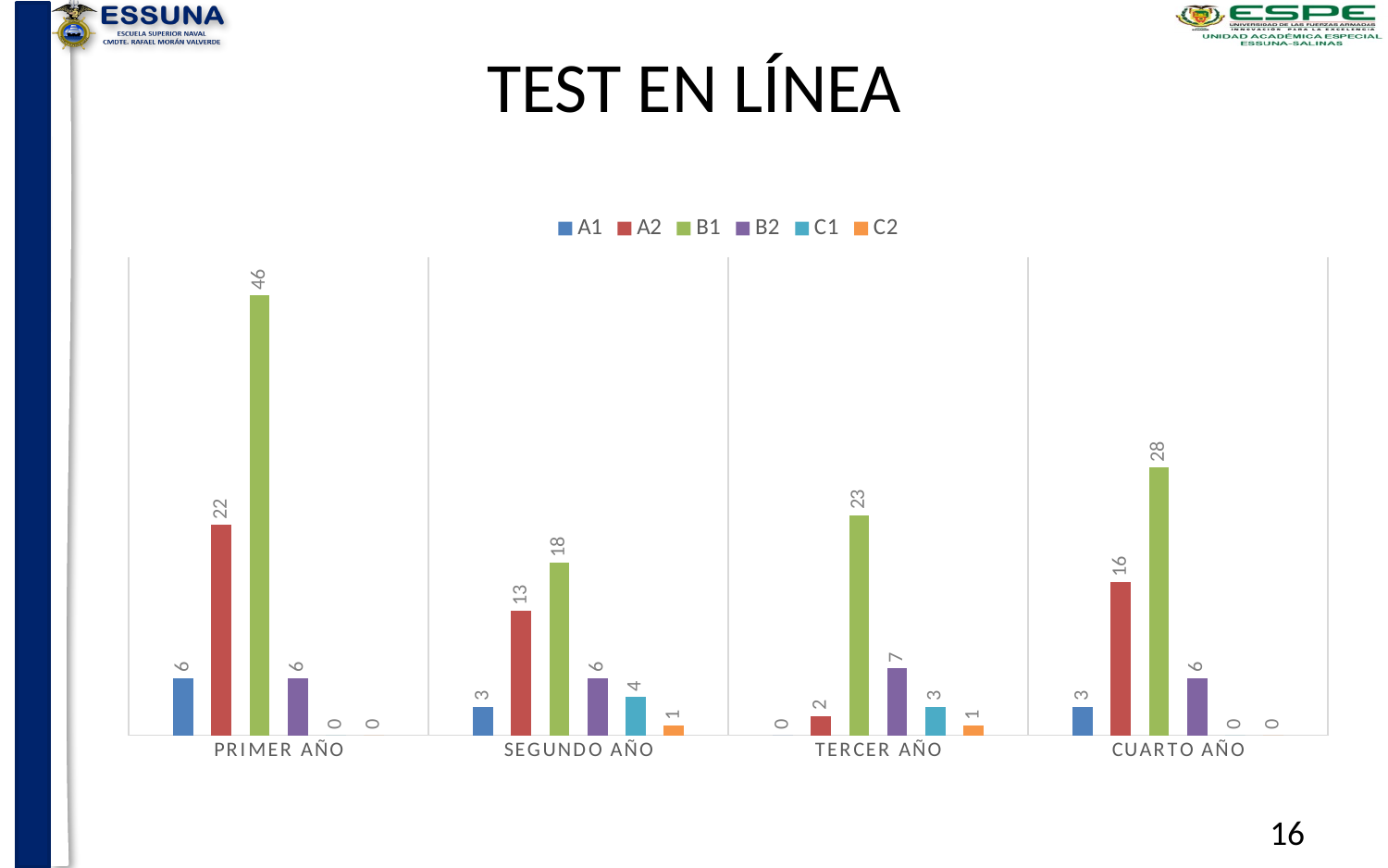
How many series does the legend list? 6 What is the difference between the B1 values for Primer Año and Cuarto Año? 18 What is the title of the chart slide? TEST EN LÍNEA What is the value of B1 for Primer Año? 46 How many year categories are shown on the x axis? 4 Which is larger: the B1 value for Segundo Año or the B1 value for Tercer Año? Tercer Año What is the total of all six series for Tercer Año? 36 Which year category has the lowest A2 value? Tercer Año Which year category has the highest B1 value? Primer Año What is the value of C1 for Segundo Año? 4 What type of chart is shown on the slide? Bar chart What is the value of A2 for Cuarto Año? 16